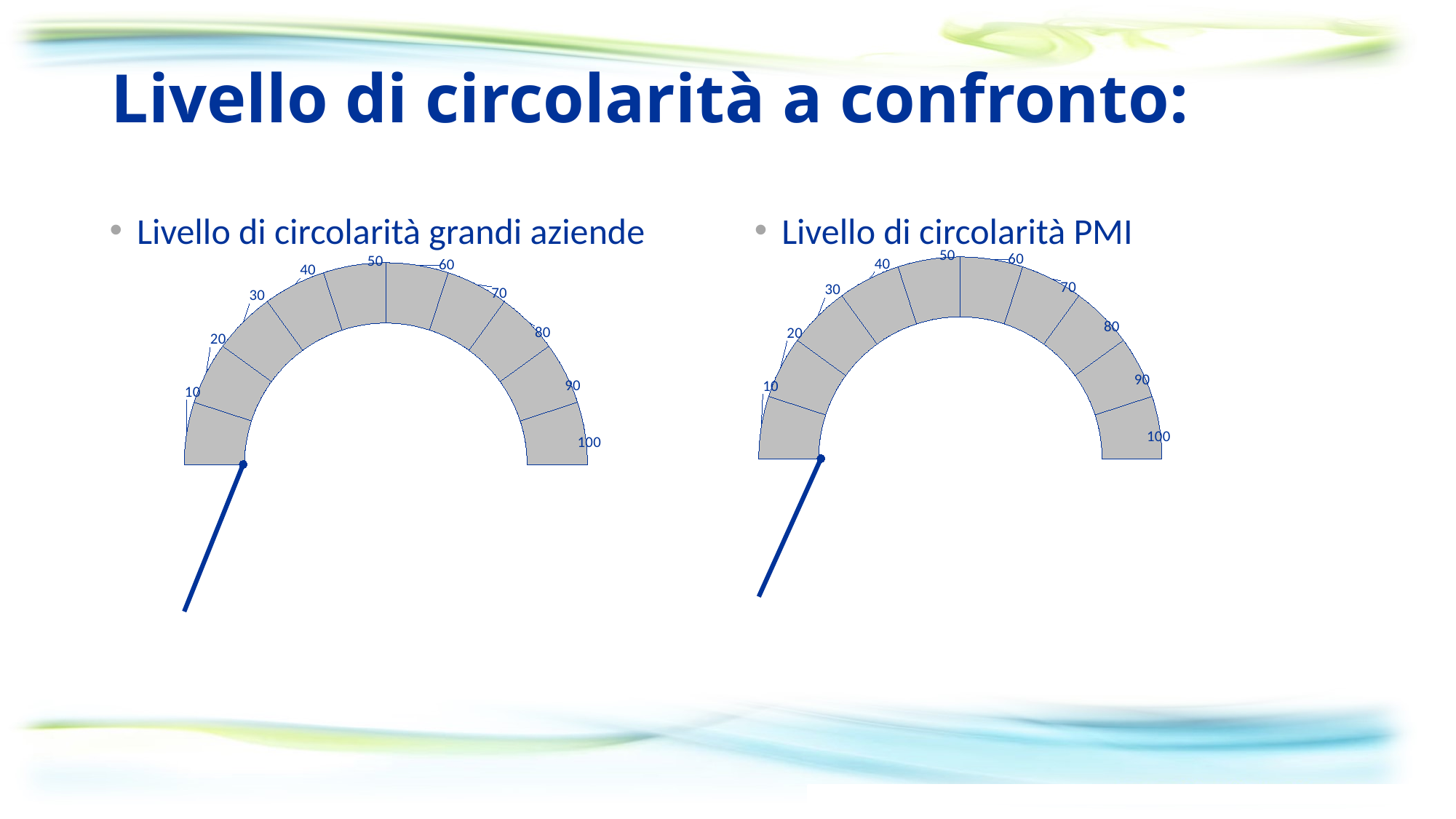
In the 'Livello di circolarità PMI' gauge, is the value indicated by the needle greater or less than 50? less What kind of chart is used for 'Livello di circolarità PMI'? Gauge chart In the 'Livello di circolarità PMI' gauge, what is the lowest tick label printed on the scale? 10 In the 'Livello di circolarità grandi aziende' gauge, which tick label sits at the top centre of the arc? 50 What is the title of the gauge chart on the right of the slide? Livello di circolarità PMI How many gauge charts are shown on the slide? 2 In the 'Livello di circolarità grandi aziende' gauge, what is the highest tick label on the scale? 100 In the 'Livello di circolarità grandi aziende' gauge, how many segments make up the arc? 10 What is the title of the gauge chart on the left of the slide? Livello di circolarità grandi aziende In the 'Livello di circolarità PMI' gauge, how many segments make up the arc? 10 What kind of chart is used for 'Livello di circolarità grandi aziende'? Gauge chart In the 'Livello di circolarità grandi aziende' gauge, is the value indicated by the needle greater or less than 50? less